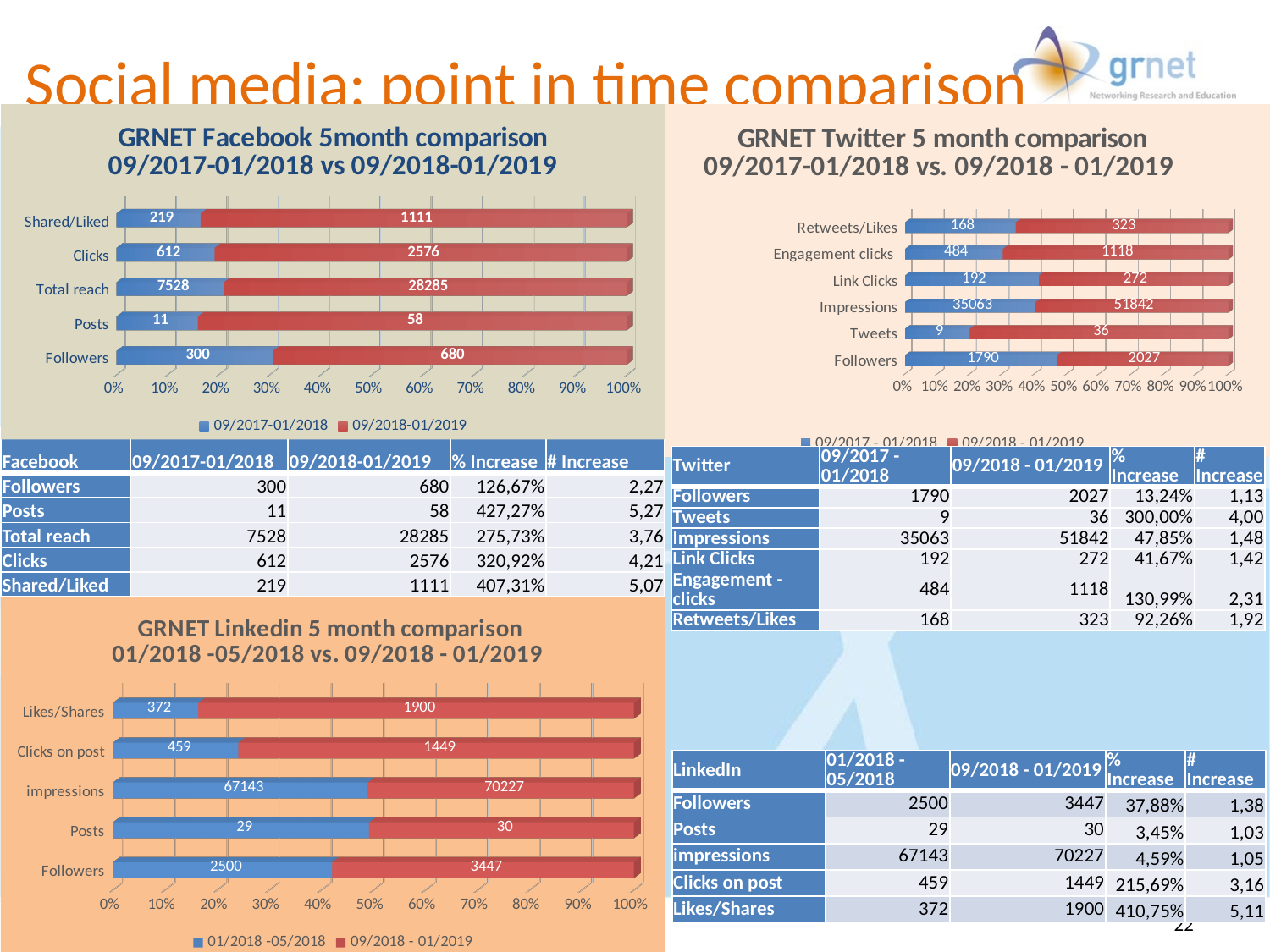
In the GRNET Facebook 5month comparison chart, what is the value for Total reach in the 09/2017-01/2018 series? 7528 How many series does the legend of the GRNET Linkedin 5 month comparison chart list? 2 How many categories does the GRNET Twitter 5 month comparison chart show? 6 How many categories does the GRNET Facebook 5month comparison chart show? 5 What kind of chart is the GRNET Linkedin 5 month comparison chart? Stacked bar chart In the GRNET Twitter 5 month comparison chart, what is the value for Tweets in the 09/2017 - 01/2018 series? 9 In the GRNET Twitter 5 month comparison chart, what is the value for Impressions in the 09/2018 - 01/2019 series? 51842 In the GRNET Facebook 5month comparison chart, what is the difference between the 09/2018-01/2019 and 09/2017-01/2018 values for Followers? 380 In the GRNET Linkedin 5 month comparison chart, what is the value for Likes/Shares in the 09/2018 - 01/2019 series? 1900 In the GRNET Facebook 5month comparison chart, what is the value for Clicks in the 09/2018-01/2019 series? 2576 In the GRNET Linkedin 5 month comparison chart, which is larger for Posts: the 01/2018 -05/2018 value or the 09/2018 - 01/2019 value? 09/2018 - 01/2019 In the GRNET Twitter 5 month comparison chart, which category has the highest 09/2018 - 01/2019 value? Impressions